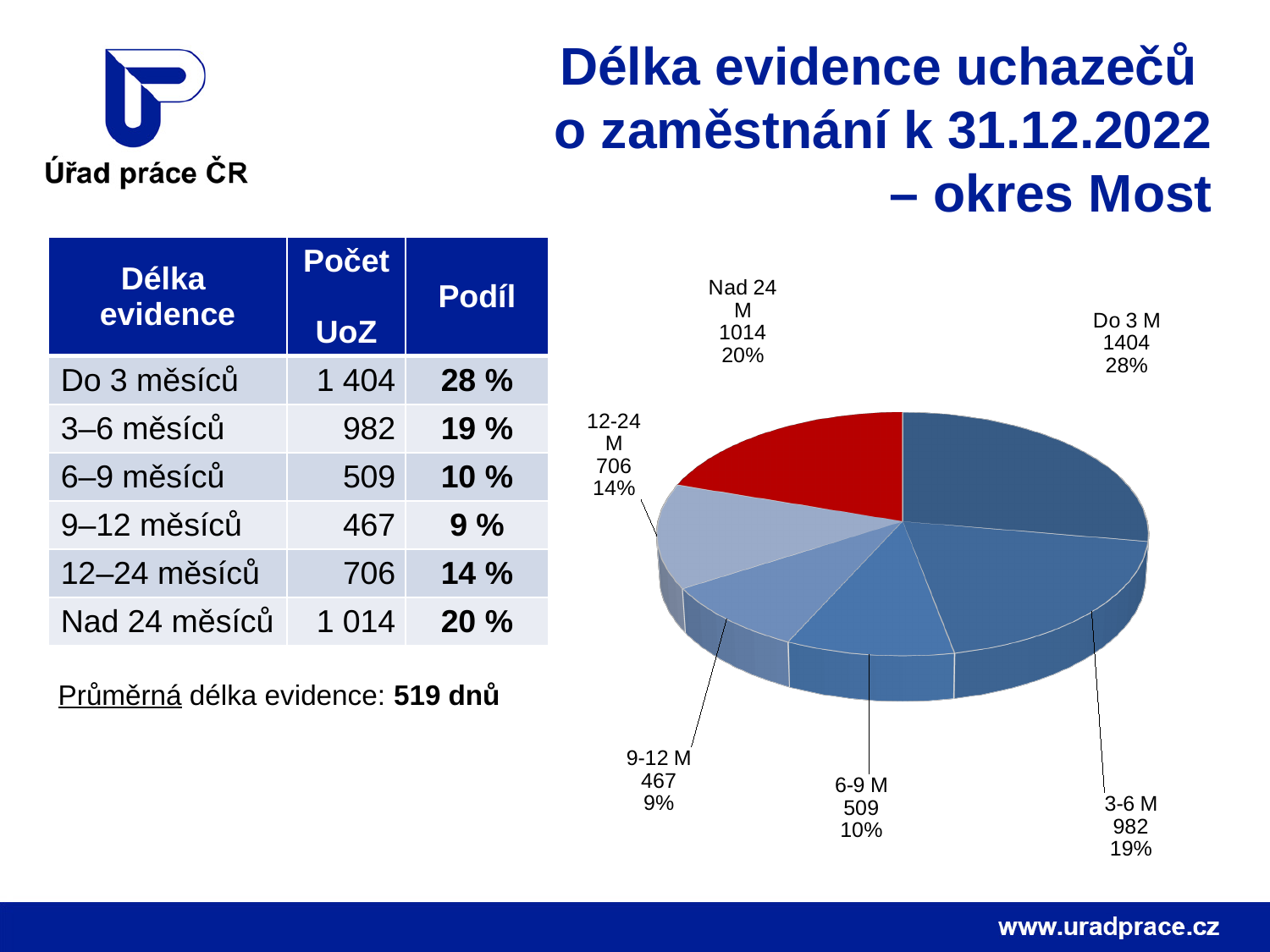
How many slices does the pie chart have? 6 What percentage share does the "6-9 M" slice have in the pie chart? 10% What kind of chart is shown on the slide? pie chart What is the value shown for the "Do 3 M" slice of the pie chart? 1404 What is the value shown for the "12-24 M" slice of the pie chart? 706 What is the difference between the values for "Do 3 M" and "3-6 M" in the pie chart? 422 Which is larger in the pie chart, the value for "Nad 24 M" or the value for "3-6 M"? Nad 24 M Which slice of the pie chart is coloured red? Nad 24 M What percentage share does the "Nad 24 M" slice have in the pie chart? 20% Which slice of the pie chart is the smallest? 9-12 M Which slice of the pie chart is the largest? Do 3 M What is the difference between the values for "6-9 M" and "9-12 M" in the pie chart? 42